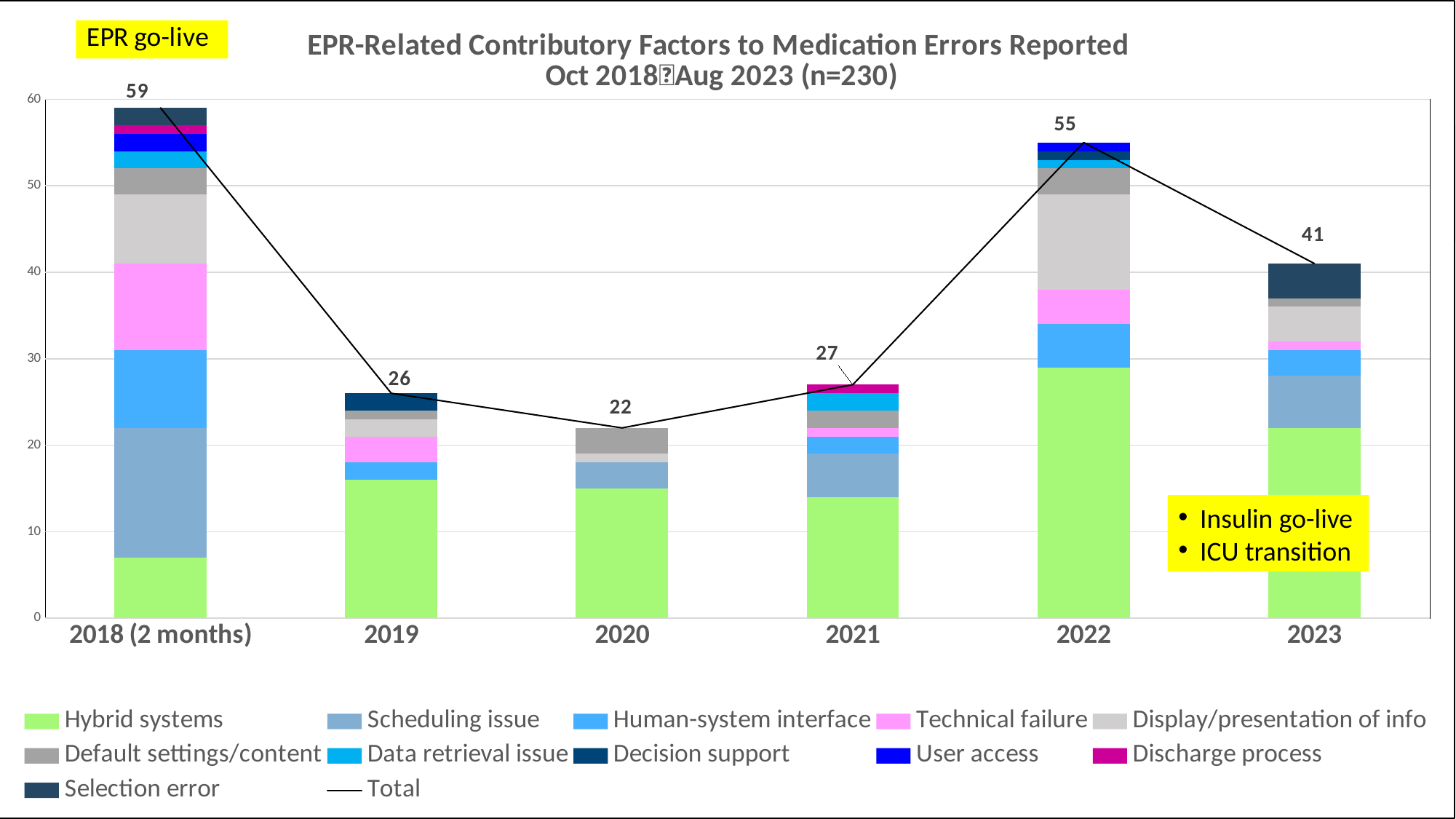
Which year has the lowest total of reported errors? 2020 How many entries does the legend list? 12 What is the difference between the totals for 2022 and 2023? 14 Which year has the highest total of reported errors? 2018 (2 months) What is the total number of medication errors reported for 2018 (2 months)? 59 Is the Hybrid systems value for 2022 greater or less than 20? greater What is the total value shown for 2020? 22 What is the difference between the totals for 2018 (2 months) and 2020? 37 Is the Hybrid systems value for 2018 (2 months) greater or less than 10? less What is the total value shown for 2022? 55 Which year has a larger total, 2019 or 2021? 2021 How many year categories are shown on the x axis? 6